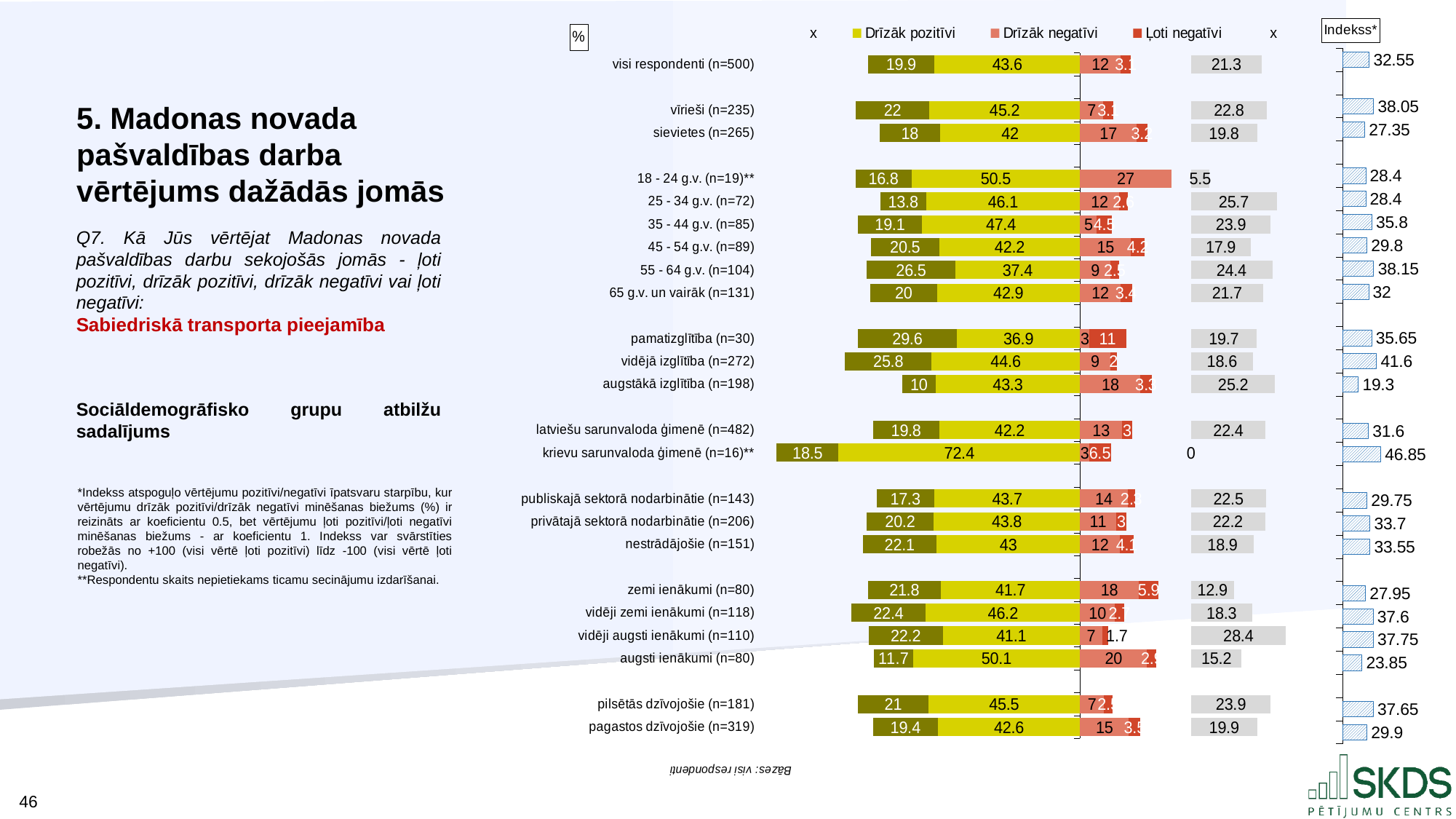
Which group has the highest Indekss* value? krievu sarunvaloda ģimenē (n=16)** Which group has the lowest Indekss* value? augstākā izglītība (n=198) Which has a larger Drīzāk pozitīvi value, vīrieši (n=235) or sievietes (n=265)? vīrieši (n=235) What is the Drīzāk negatīvi value for 18 - 24 g.v. (n=19)**? 27 What is the Indekss* value for krievu sarunvaloda ģimenē (n=16)**? 46.85 Which group has the highest Drīzāk pozitīvi value? krievu sarunvaloda ģimenē (n=16)** What kind of chart is used to show the response distribution by group? Stacked bar chart What is the Drīzāk pozitīvi value for visi respondenti (n=500)? 43.6 What is the Indekss* value for pilsētās dzīvojošie (n=181)? 37.65 What is the difference between the Indekss* values for vīrieši (n=235) and sievietes (n=265)? 10.7 What is the Ļoti negatīvi value for pamatizglītība (n=30)? 11 What is the difference between the Drīzāk pozitīvi values for augsti ienākumi (n=80) and zemi ienākumi (n=80)? 8.4